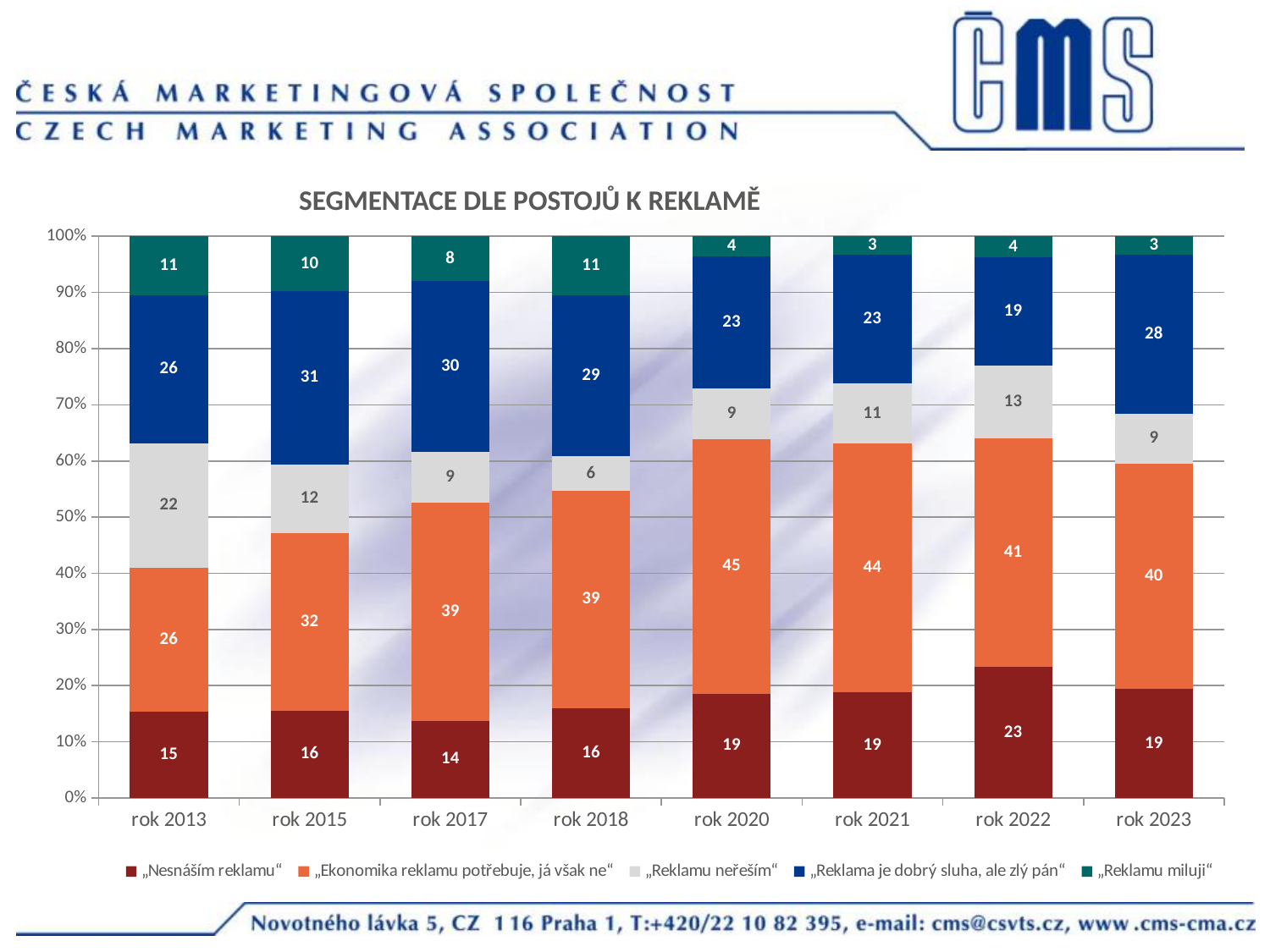
What is the value for "Reklamu neřeším" in rok 2013? 22 What is the value for "Nesnáším reklamu" in rok 2022? 23 In which year is the value for "Reklamu miluji" lowest? rok 2021 and rok 2023 (3) What is the value for "Reklama je dobrý sluha, ale zlý pán" in rok 2023? 28 What kind of chart is shown on the slide? Stacked bar chart What is the value for "Ekonomika reklamu potřebuje, já však ne" in rok 2020? 45 What is the difference between the "Reklamu neřeším" values in rok 2013 and rok 2018? 16 What is the title of the chart? SEGMENTACE DLE POSTOJŮ K REKLAMĚ In which year is the value for "Ekonomika reklamu potřebuje, já však ne" highest? rok 2020 How many years are shown on the x axis? 8 Which is larger: the "Reklama je dobrý sluha, ale zlý pán" value in rok 2015 or in rok 2022? rok 2015 How many series does the legend list? 5